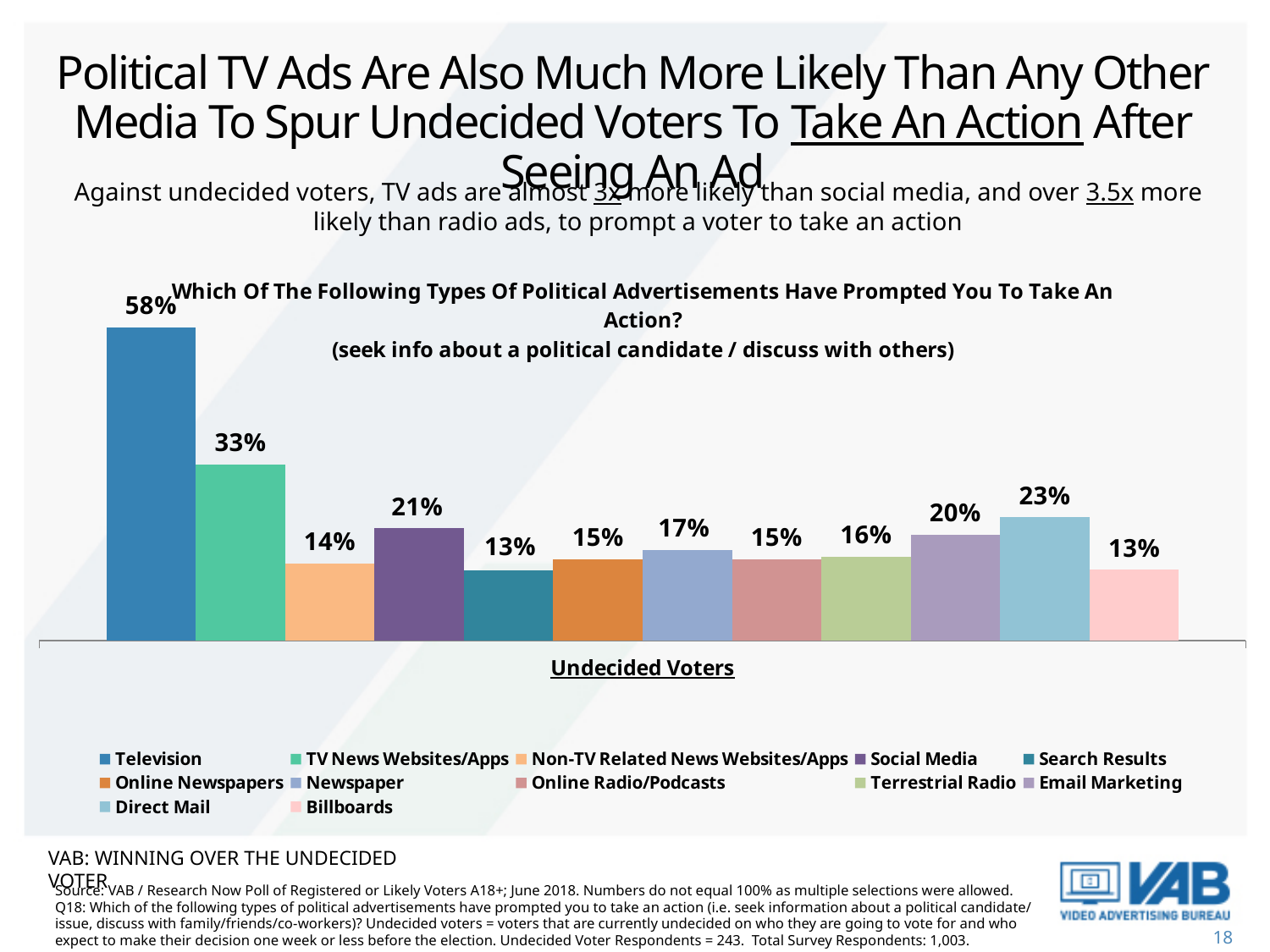
What is the difference between the Television value and the TV News Websites/Apps value? 25% Which is larger, the value for Direct Mail or the value for Non-TV Related News Websites/Apps? Direct Mail How many series does the legend list? 12 What kind of chart is shown on the slide? Bar chart Which type of political advertisement has the highest value in the chart? Television What percentage of undecided voters said Television ads prompted them to take an action? 58% What is the value shown for Terrestrial Radio? 16% What is the category label shown beneath the bars on the x axis? Undecided Voters What is the value shown for Direct Mail? 23% Which is larger, the value for Email Marketing or the value for Newspaper? Email Marketing What is the difference between the Television value and the Social Media value? 37% What is the value shown for Social Media? 21%